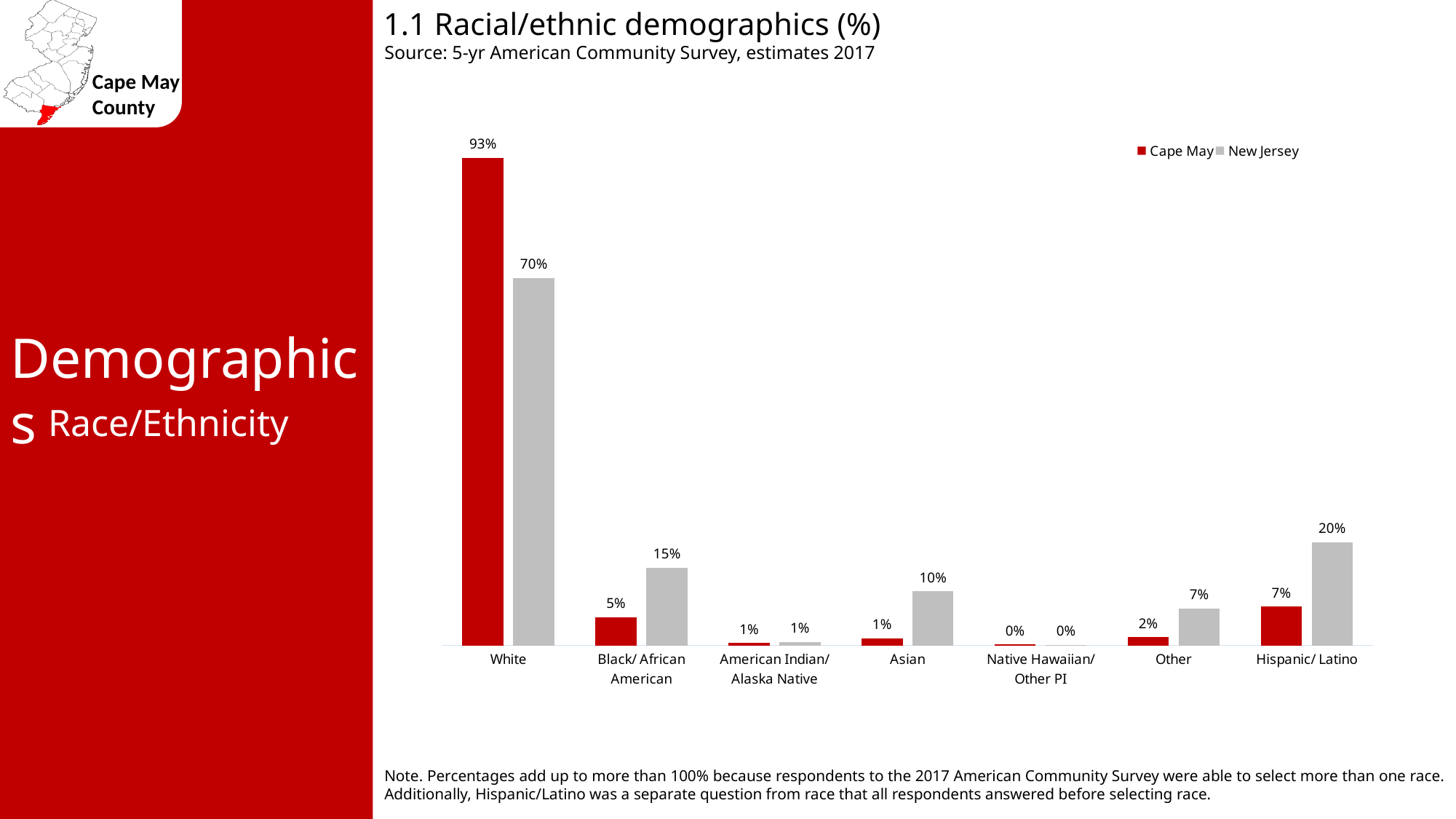
What is the New Jersey value for Black/ African American? 15% What is the difference between the New Jersey and Cape May values for Hispanic/ Latino? 13% What kind of chart is shown on the slide? Bar chart What is the difference between the Cape May and New Jersey values for White? 23% What is the New Jersey value for Hispanic/ Latino? 20% Which category has the lowest New Jersey value? Native Hawaiian/ Other PI What is the Cape May value for White? 93% How many series does the legend list? 2 Which is larger for Asian: the Cape May value or the New Jersey value? New Jersey Which category has the highest Cape May value? White How many categories are shown on the x axis? 7 What is the Cape May value for Asian? 1%